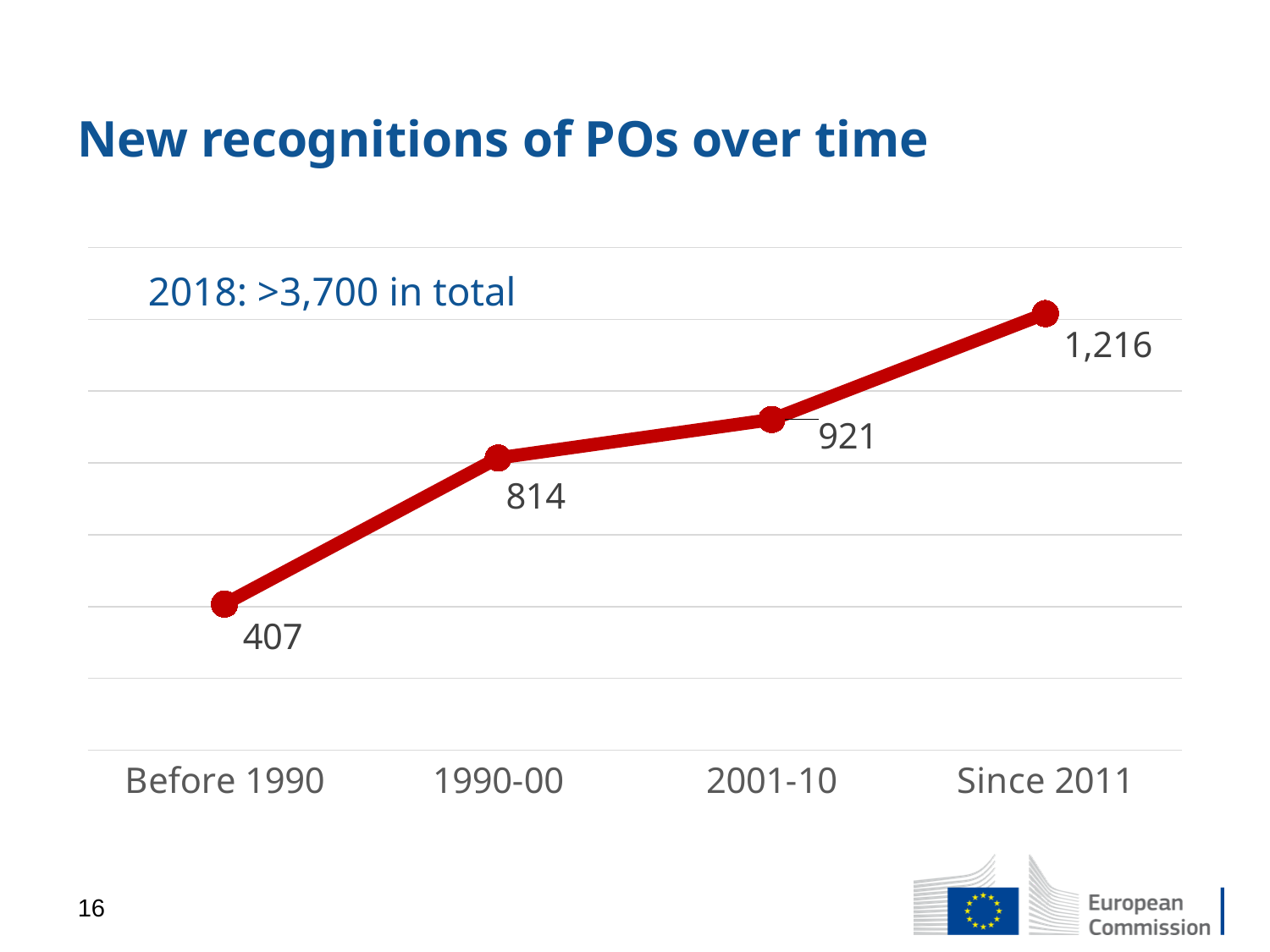
What is the value for Since 2011? 1,216 How many periods are plotted on the chart? 4 What is the difference between the values for Since 2011 and 2001-10? 295 Which period has the highest value? Since 2011 What is the difference between the values for 1990-00 and Before 1990? 407 What kind of chart is shown? Line chart What is the value for 1990-00? 814 What is the value for 2001-10? 921 Which period has the lowest value? Before 1990 What is the value for Before 1990? 407 Do the values rise or fall from Before 1990 to Since 2011? Rise Which is larger, the value for 1990-00 or the value for 2001-10? 2001-10